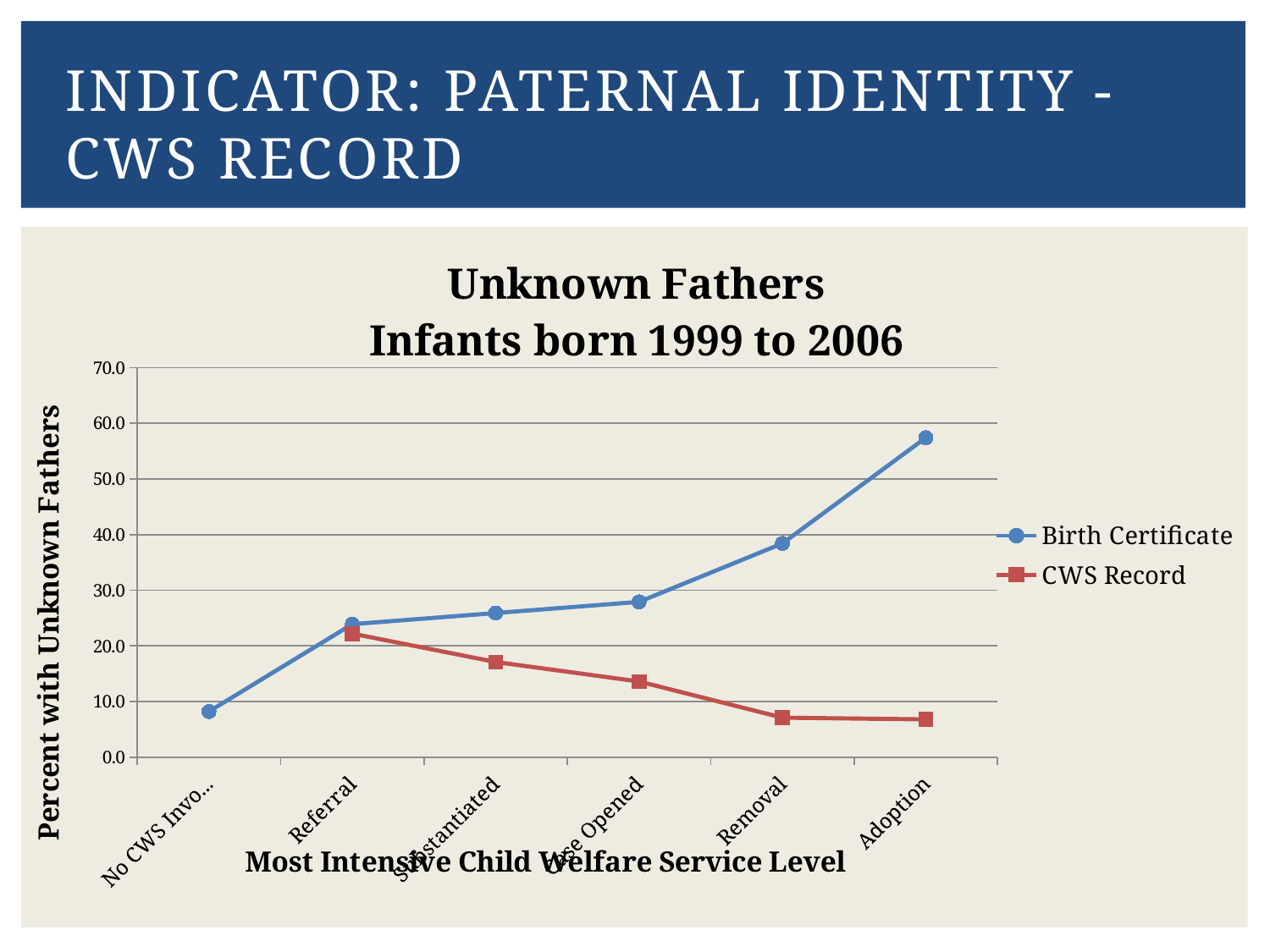
Which category has the highest value for the CWS Record series? Referral How many series does the legend list? 2 What kind of chart is shown on the slide? Line chart Is the CWS Record value for Removal greater or less than 10.0? less How many categories are shown on the x axis? 6 Is the Birth Certificate value for Adoption greater or less than 50.0? greater What is the label of the y axis? Percent with Unknown Fathers Is the Birth Certificate value for Removal greater or less than 30.0? greater Does the Birth Certificate series rise or fall from Referral to Adoption? Rise At Substantiated, which series has the larger value, Birth Certificate or CWS Record? Birth Certificate Does the CWS Record series rise or fall from Referral to Adoption? Fall Which category has the highest value for the Birth Certificate series? Adoption